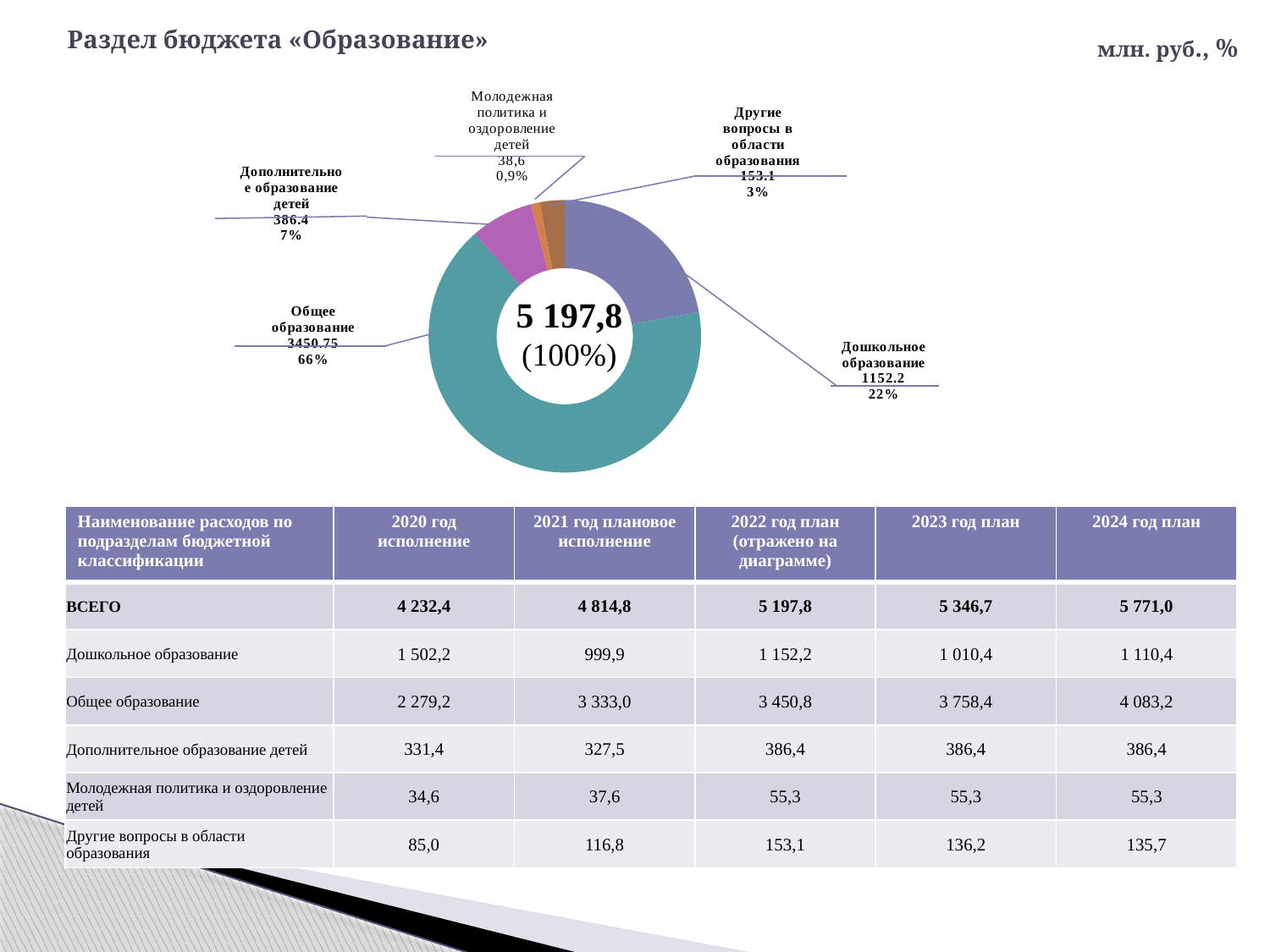
What total value is shown in the centre of the chart? 5 197,8 What is the difference between the values for Дошкольное образование (1152.2) and Дополнительное образование детей (386.4) in the chart? 765.8 What value is shown for Дополнительное образование детей in the chart? 386.4 What share of the chart does Дошкольное образование account for? 22% Which is larger in the chart, Дошкольное образование or Дополнительное образование детей? Дошкольное образование What value is shown for Другие вопросы в области образования in the chart? 153.1 Which category has the smallest share in the chart? Молодежная политика и оздоровление детей Which category has the largest share in the chart? Общее образование What units are indicated for the chart in the top right of the slide? млн. руб., % What kind of chart is shown on the slide? doughnut (pie) chart How many categories are shown in the chart? 5 What share of the chart does Общее образование account for? 66%